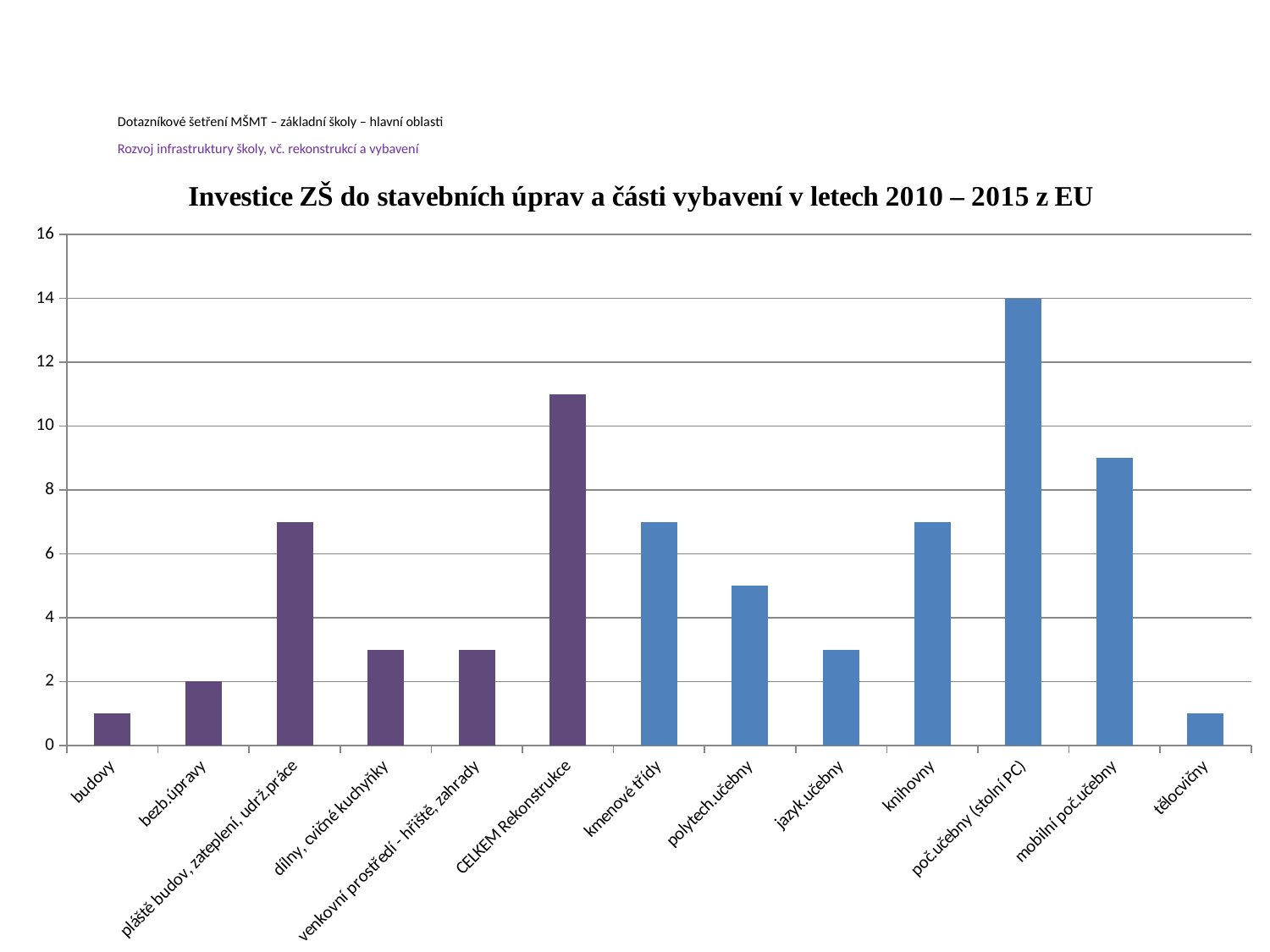
Is the value for polytech.učebny greater or less than 6? less Is the value for mobilní poč.učebny greater or less than 8? greater What is the title of the chart? Investice ZŠ do stavebních úprav a části vybavení v letech 2010 – 2015 z EU Which is larger, the value for CELKEM Rekonstrukce or the value for poč.učebny (stolní PC)? poč.učebny (stolní PC) How many categories are shown on the x axis of the chart? 13 Which category has the highest bar in the chart? poč.učebny (stolní PC) Which is larger, the value for kmenové třídy or the value for polytech.učebny? kmenové třídy What is the value for bezb.úpravy? 2 What type of chart is shown on the slide? bar chart Is the value for CELKEM Rekonstrukce greater or less than 10? greater What is the value for poč.učebny (stolní PC)? 14 What is the difference between the values for poč.učebny (stolní PC) and bezb.úpravy? 12